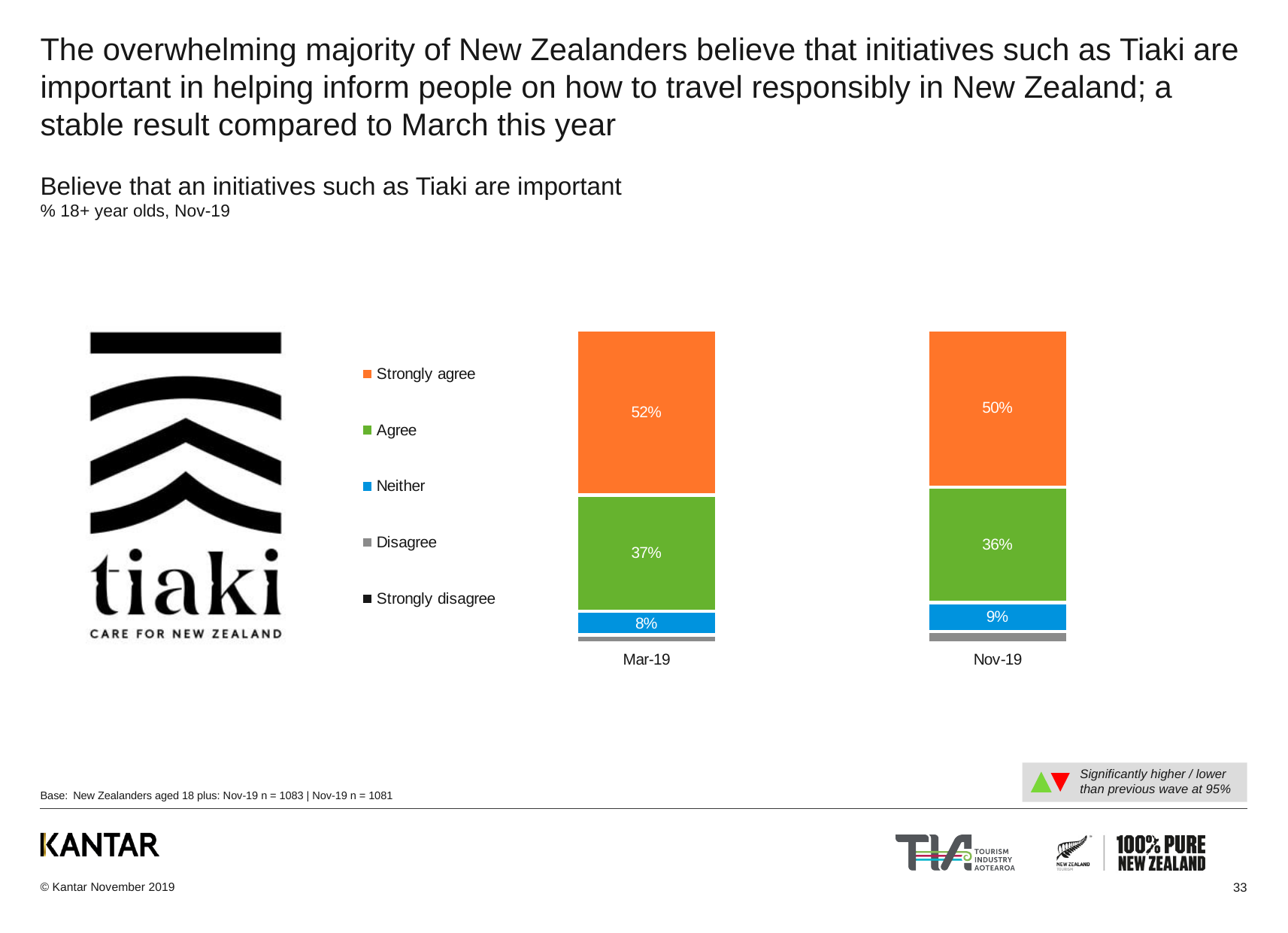
What type of chart is shown on the slide? Stacked bar chart How many series does the legend list? 5 Which response category has the largest share in the Nov-19 bar? Strongly agree What is the 'Agree' value for Nov-19? 36% How many waves (bars) are shown on the chart? 2 By how many percentage points did 'Strongly agree' change from Mar-19 to Nov-19? 2 percentage points Which wave has the higher 'Agree' value, Mar-19 or Nov-19? Mar-19 What percentage of respondents strongly agreed in Nov-19? 50% What is the 'Neither' value for Nov-19? 9% What is the 'Neither' value for Mar-19? 8% What percentage of respondents strongly agreed in Mar-19? 52% Which colour represents 'Strongly agree' in the legend? Orange